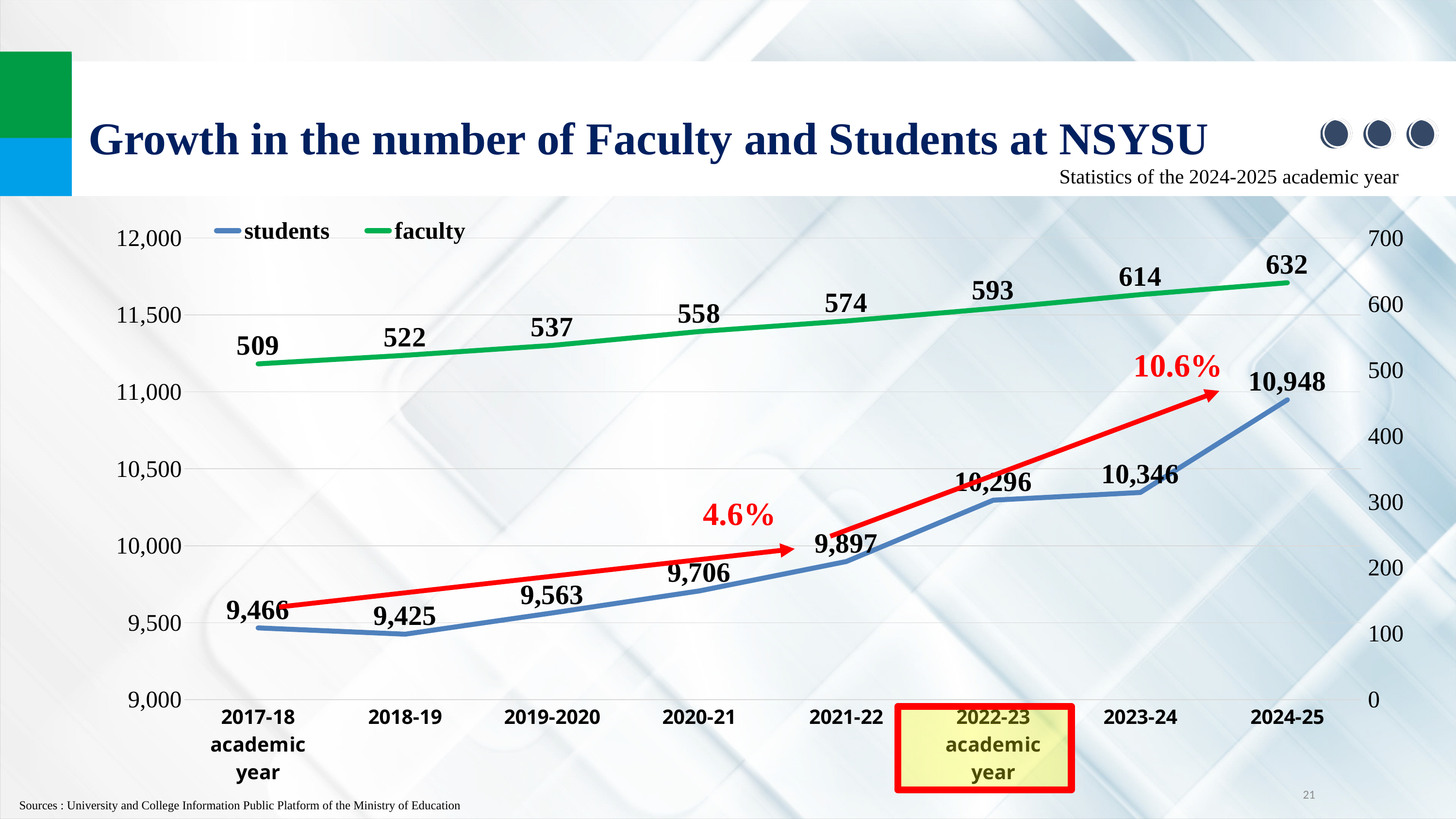
In which academic year is the number of students lowest? 2018-19 What is the number of students in the 2021-22 academic year? 9,897 What is the number of students in the 2024-25 academic year? 10,948 What is the difference in the number of students between 2022-23 and 2021-22? 399 What type of chart is shown on the slide? line chart What is the number of faculty in the 2017-18 academic year? 509 Does the number of faculty rise or fall from 2017-18 to 2024-25? rise How many academic years are plotted on the x axis? 8 What is the difference in the number of faculty between 2024-25 and 2017-18? 123 In which academic year is the number of faculty highest? 2024-25 How many series does the legend list? 2 Which is larger, the number of students in 2019-2020 or in 2020-21? 2020-21